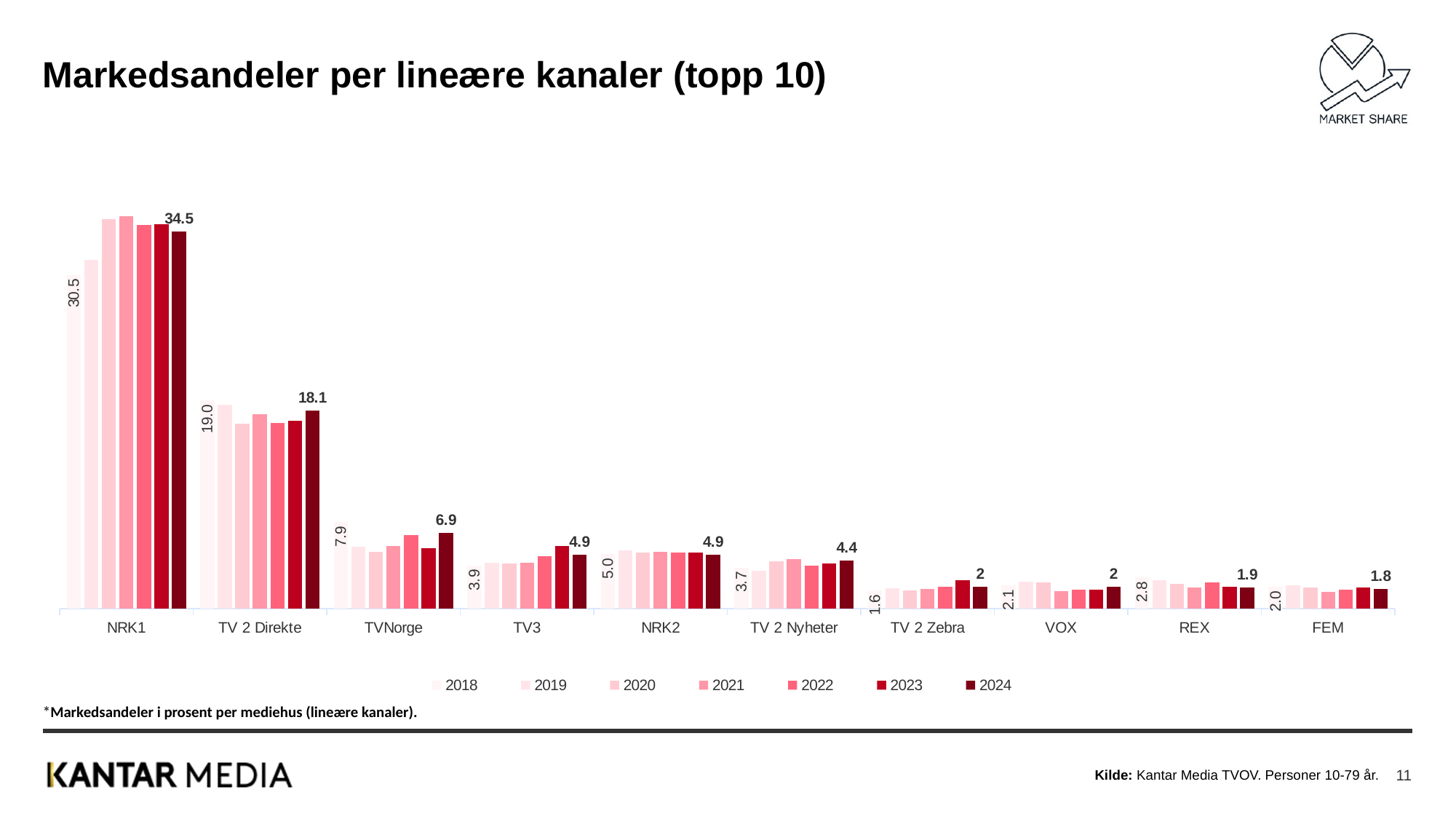
What is the title of the chart? Markedsandeler per lineære kanaler (topp 10) What is the 2024 market share for NRK1? 34.5 How many series does the legend list? 7 Which channel has the lowest 2024 market share? FEM What is the 2018 market share for TV 2 Direkte? 19.0 Which is larger for TVNorge: the 2018 value or the 2024 value? 2018 What is the difference between NRK1's 2024 value and its 2018 value? 4.0 Which channel has the highest 2024 market share? NRK1 How many channels (categories) are shown on the x axis? 10 What is the 2024 value for TVNorge? 6.9 What type of chart is shown on the slide? Bar chart What is the 2018 value for REX? 2.8